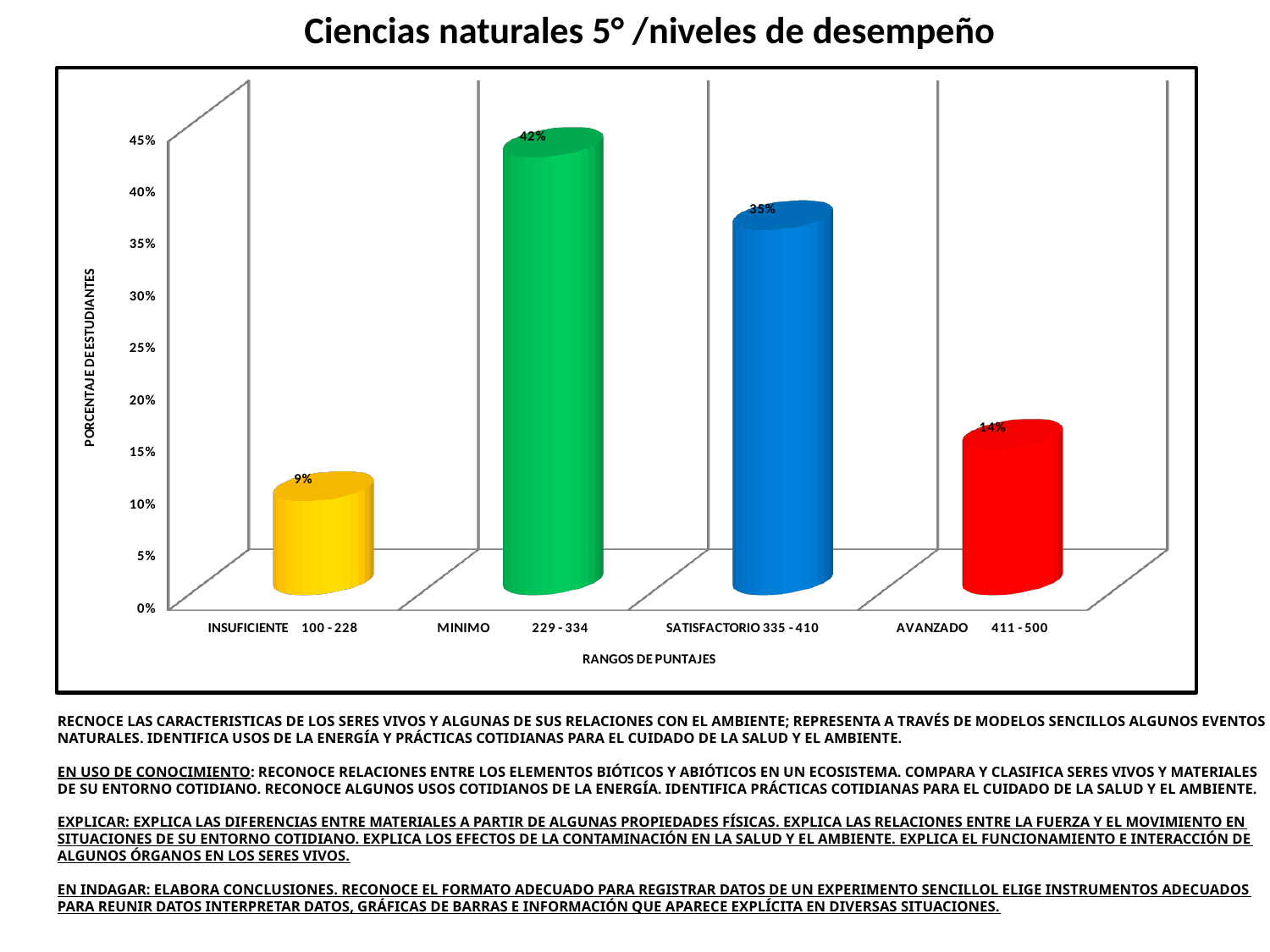
What kind of chart is shown on the slide? Bar chart Which performance level has the highest percentage of students? MINIMO Which performance level has the lowest percentage of students? INSUFICIENTE What is the difference in percentage points between the MINIMO and SATISFACTORIO levels? 7% What percentage of students are in the SATISFACTORIO level? 35% What percentage of students are in the MINIMO level? 42% Which has a larger percentage of students, AVANZADO or INSUFICIENTE? AVANZADO What is the title of the chart? Ciencias naturales 5° /niveles de desempeño How many performance levels are shown on the chart? 4 What percentage of students are in the AVANZADO level? 14% What percentage of students are in the INSUFICIENTE level? 9% What is the label of the vertical axis? PORCENTAJE DE ESTUDIANTES